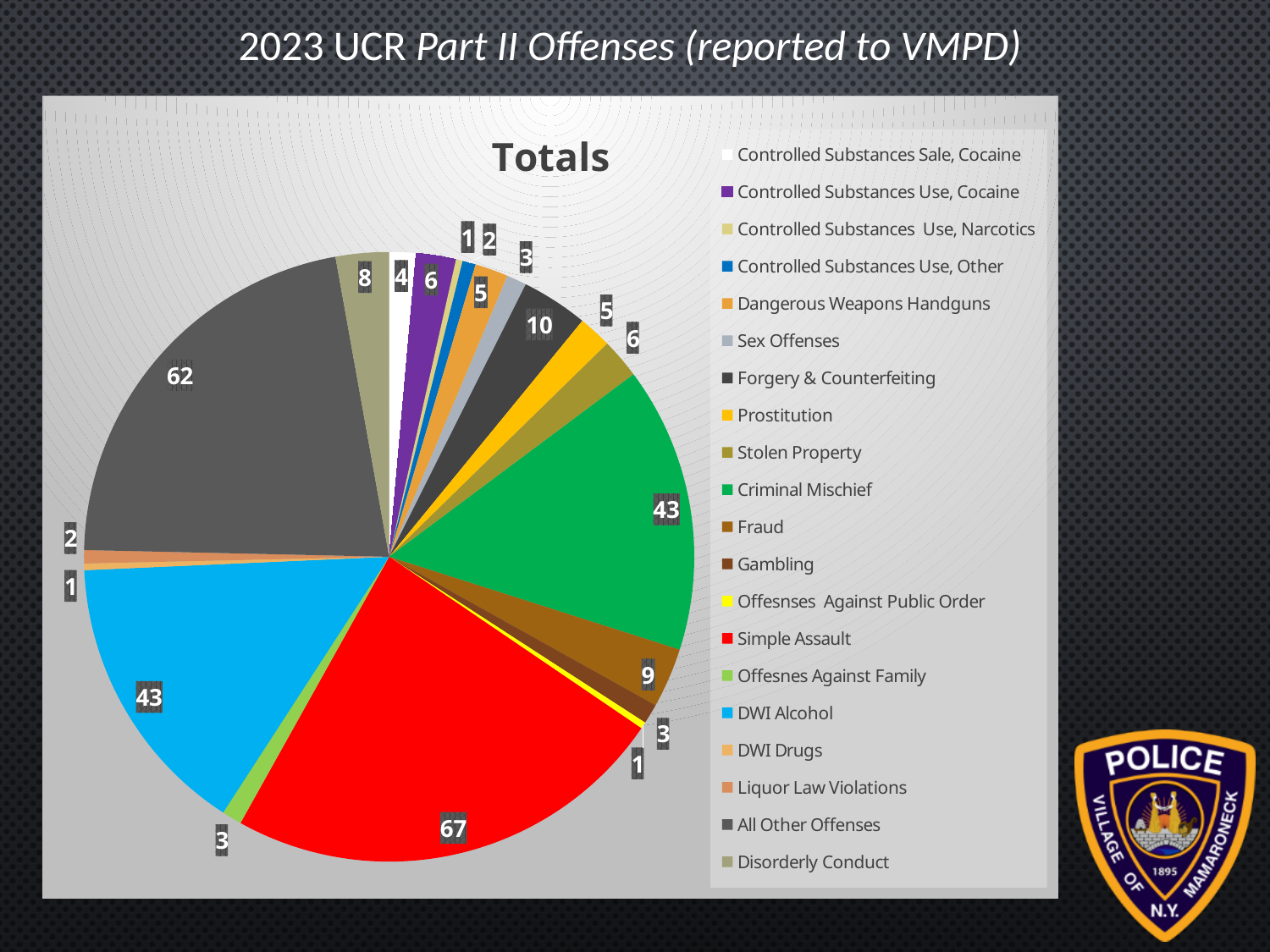
What is the value for Disorderly Conduct? 8 What is the difference between the values for Simple Assault and All Other Offenses? 5 What is the value for All Other Offenses? 62 What kind of chart is shown on the slide? pie chart Which is larger, the value for Criminal Mischief or the value for Fraud? Criminal Mischief Which category has the largest slice of the pie? Simple Assault How many categories does the legend list? 20 What is the value for Criminal Mischief? 43 What is the value for Forgery & Counterfeiting? 10 What is the title of the chart? Totals Which is larger, the value for Forgery & Counterfeiting or the value for Fraud? Forgery & Counterfeiting What is the value for Simple Assault? 67